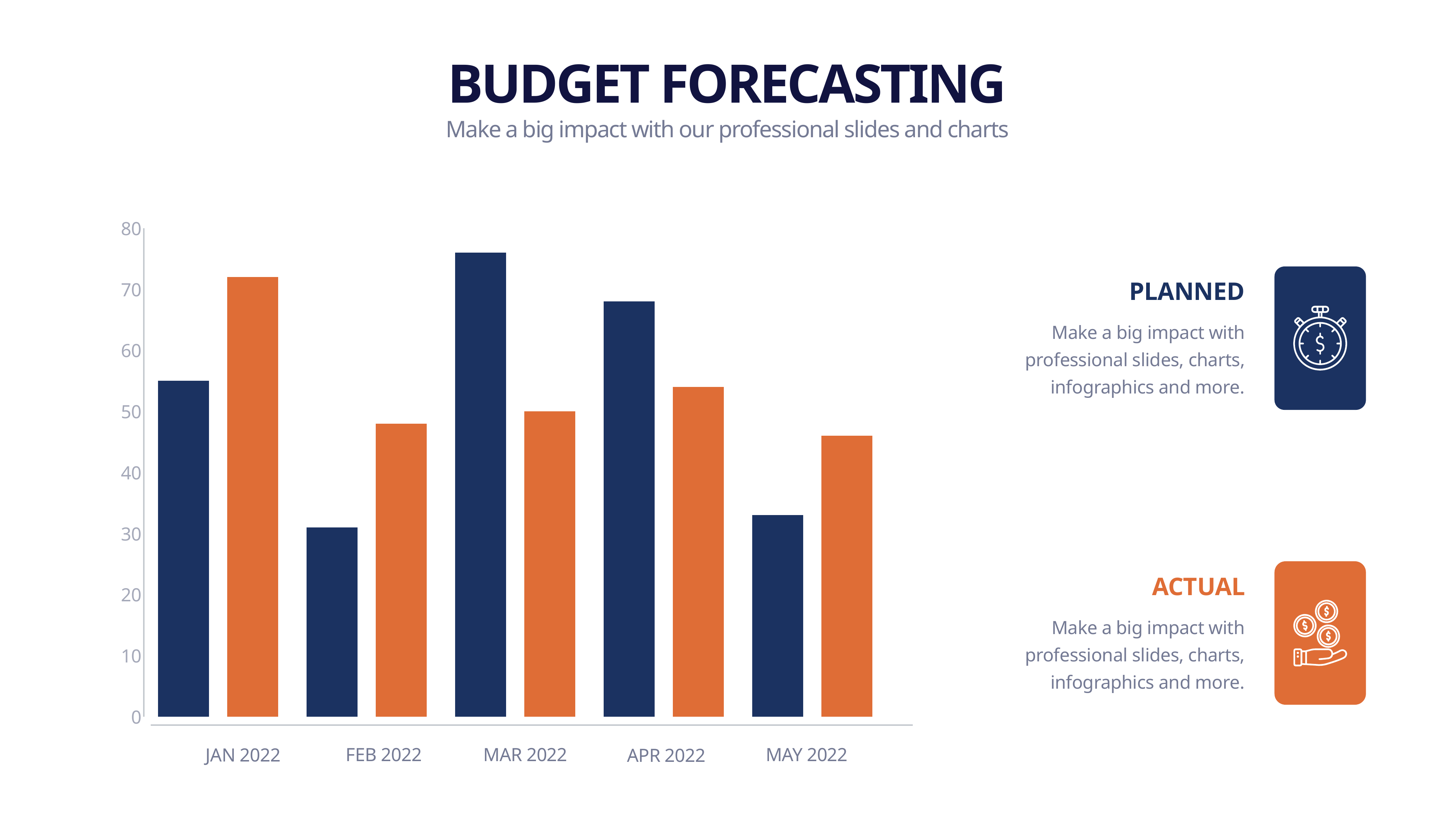
Is the Planned value for MAR 2022 greater or less than 70? greater How many months are shown on the x axis of the chart? 5 Which month has the highest Actual value? JAN 2022 How many data series does the chart show? 2 Is the Actual value for JAN 2022 greater or less than 60? greater Which month has the highest Planned value? MAR 2022 In MAR 2022, which is larger, the Planned value or the Actual value? Planned In JAN 2022, which is larger, the Planned value or the Actual value? Actual What colour are the bars for the Actual series? orange What kind of chart is shown on the slide? bar chart Is the Planned value for FEB 2022 greater or less than 40? less What is the title of the slide containing the chart? BUDGET FORECASTING